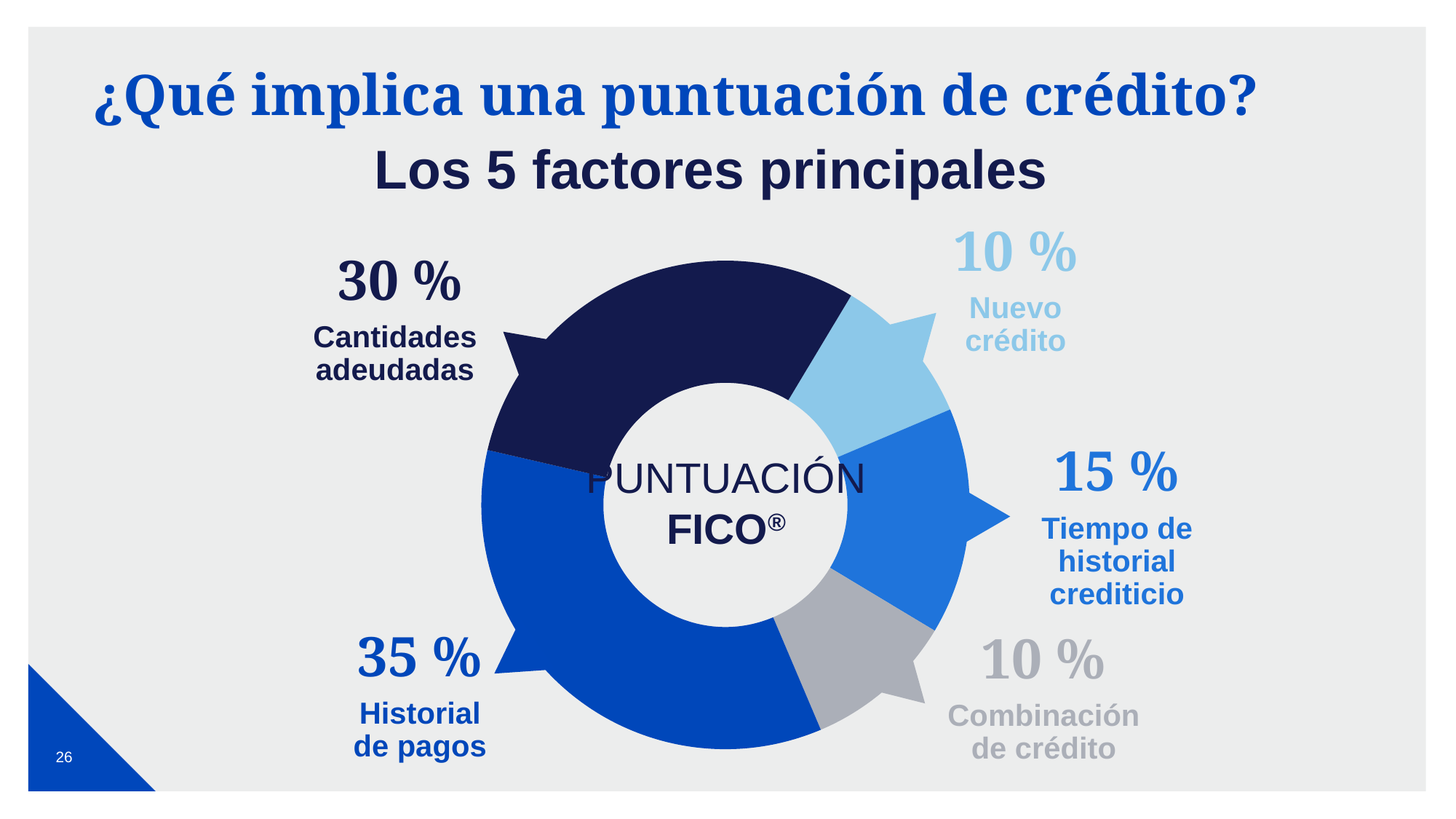
Which is larger, the share for Tiempo de historial crediticio or the share for Combinación de crédito? Tiempo de historial crediticio Which factor is shown in grey? Combinación de crédito Which factor has the largest share of the FICO score? Historial de pagos What share of the FICO score does Cantidades adeudadas account for? 30 % How many factors are shown in the chart? 5 What kind of chart is shown on the slide? Doughnut chart What text appears in the centre of the chart? PUNTUACIÓN FICO® What share of the FICO score does Nuevo crédito account for? 10 % What is the difference between the shares for Historial de pagos and Cantidades adeudadas? 5 % What is the difference between the shares for Cantidades adeudadas and Tiempo de historial crediticio? 15 % What share of the FICO score does Tiempo de historial crediticio account for? 15 % What share of the FICO score does Historial de pagos account for? 35 %